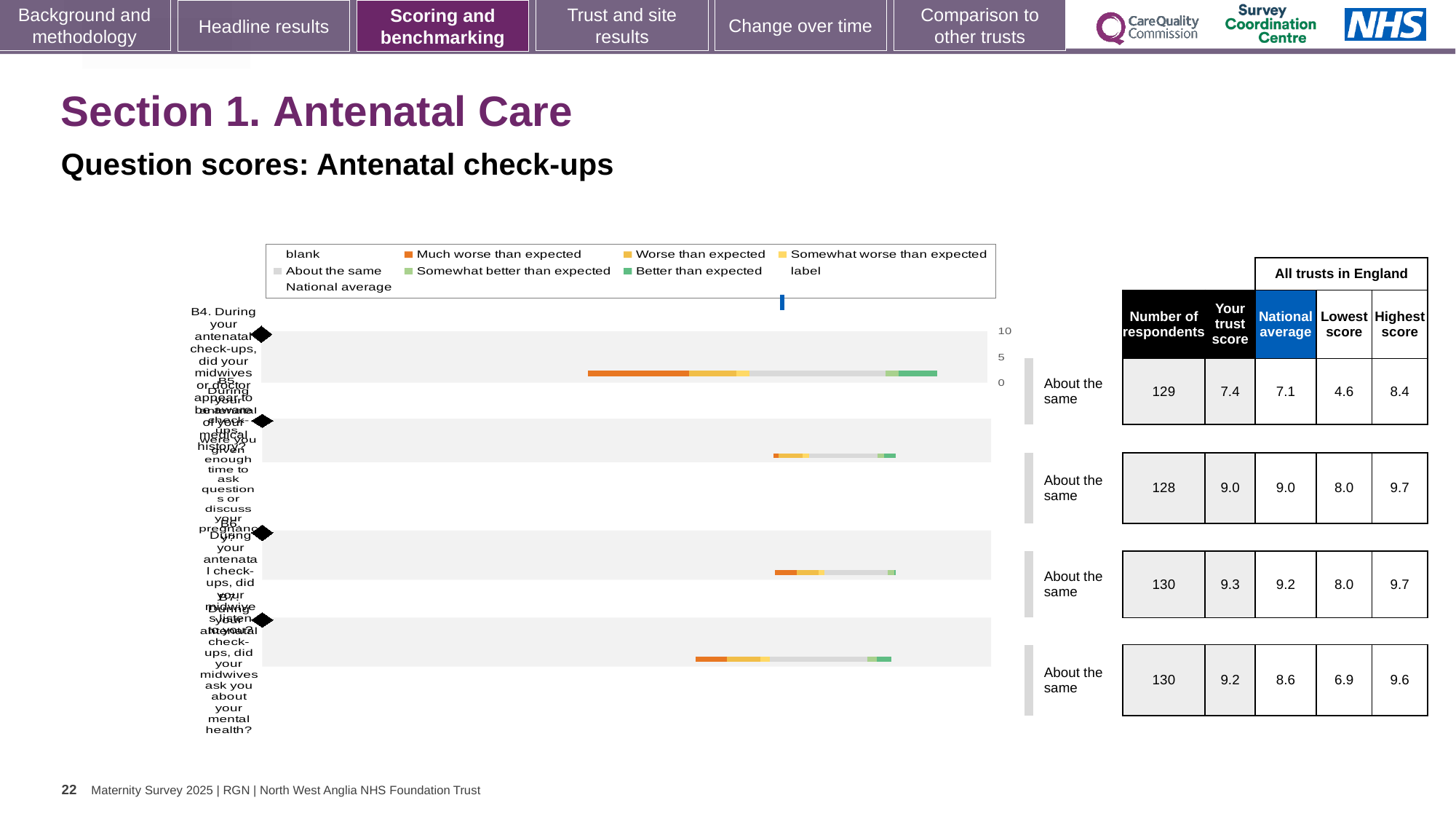
What is the national average for the first row (B4)? 7.1 How many question rows (bars) are plotted in the chart? 4 In the legend, what colour represents 'Much worse than expected'? orange What is the number of respondents for the second row of the table? 128 What is the difference between the trust score and the national average for the last row (B7, mental health)? 0.6 What kind of chart is shown on the slide? bar chart Which row has the lowest 'Your trust score'? the first row, B4 (7.4) Which row has the highest 'Your trust score'? the third row (9.3) What is the lowest score across all trusts in England for the last row (B7, mental health)? 6.9 Is the trust score for the first row (B4) larger or smaller than its national average? larger What is the 'Your trust score' for the first row (B4, awareness of medical history)? 7.4 What is the highest score across all trusts in England for the third row of the table? 9.7